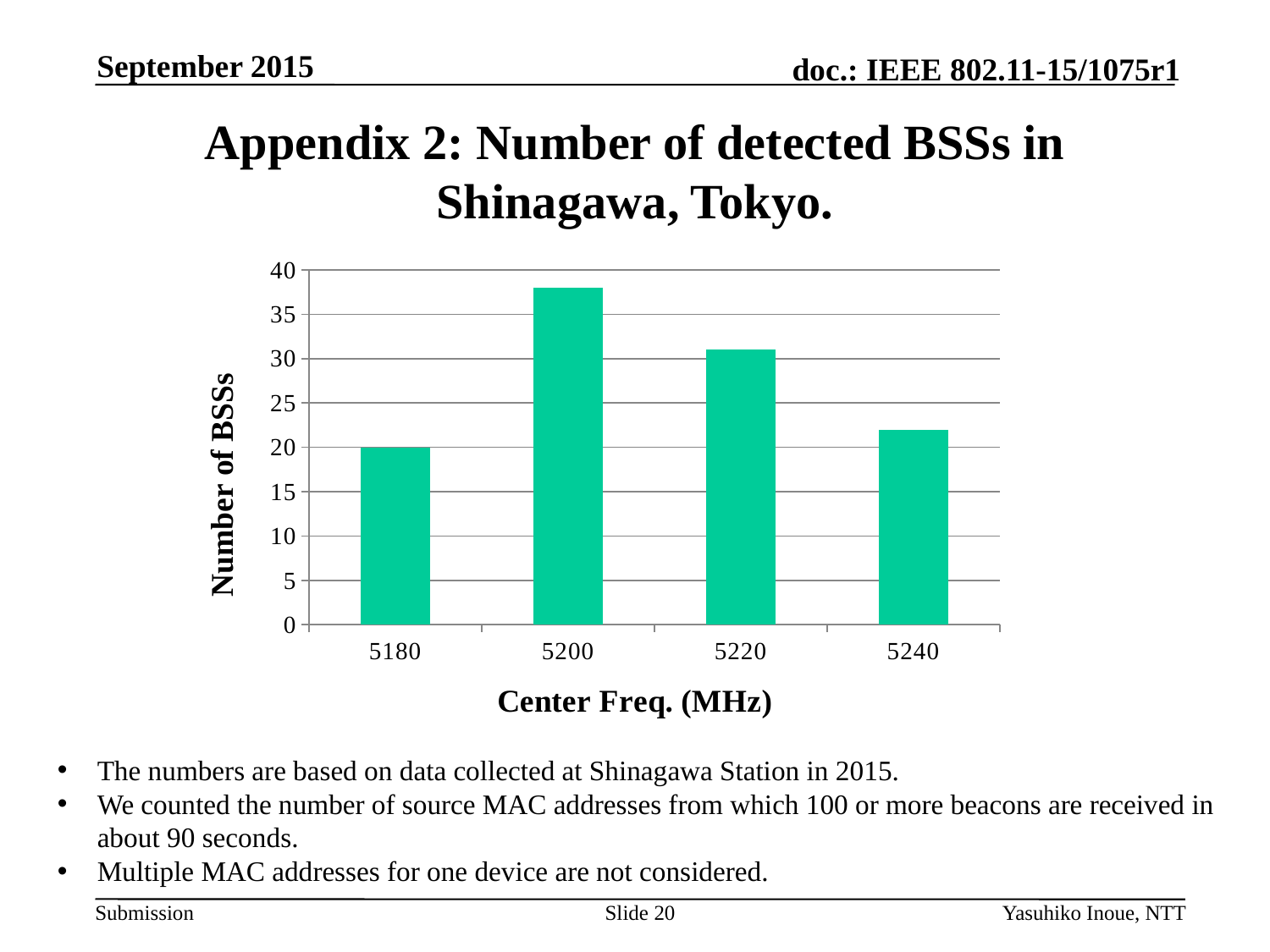
Is the number of BSSs at 5200 MHz greater or less than 35? greater Is the number of BSSs at 5180 MHz greater or less than 25? less Is the number of BSSs at 5240 MHz greater or less than 25? less What is the label of the y axis of the chart? Number of BSSs What is the label of the x axis of the chart? Center Freq. (MHz) What kind of chart is shown on the slide? bar chart Which center frequency has the lowest number of BSSs? 5180 Which has more detected BSSs, 5200 MHz or 5220 MHz? 5200 Which has more detected BSSs, 5220 MHz or 5240 MHz? 5220 Which center frequency has the highest number of BSSs? 5200 How many center frequencies are shown on the x axis of the chart? 4